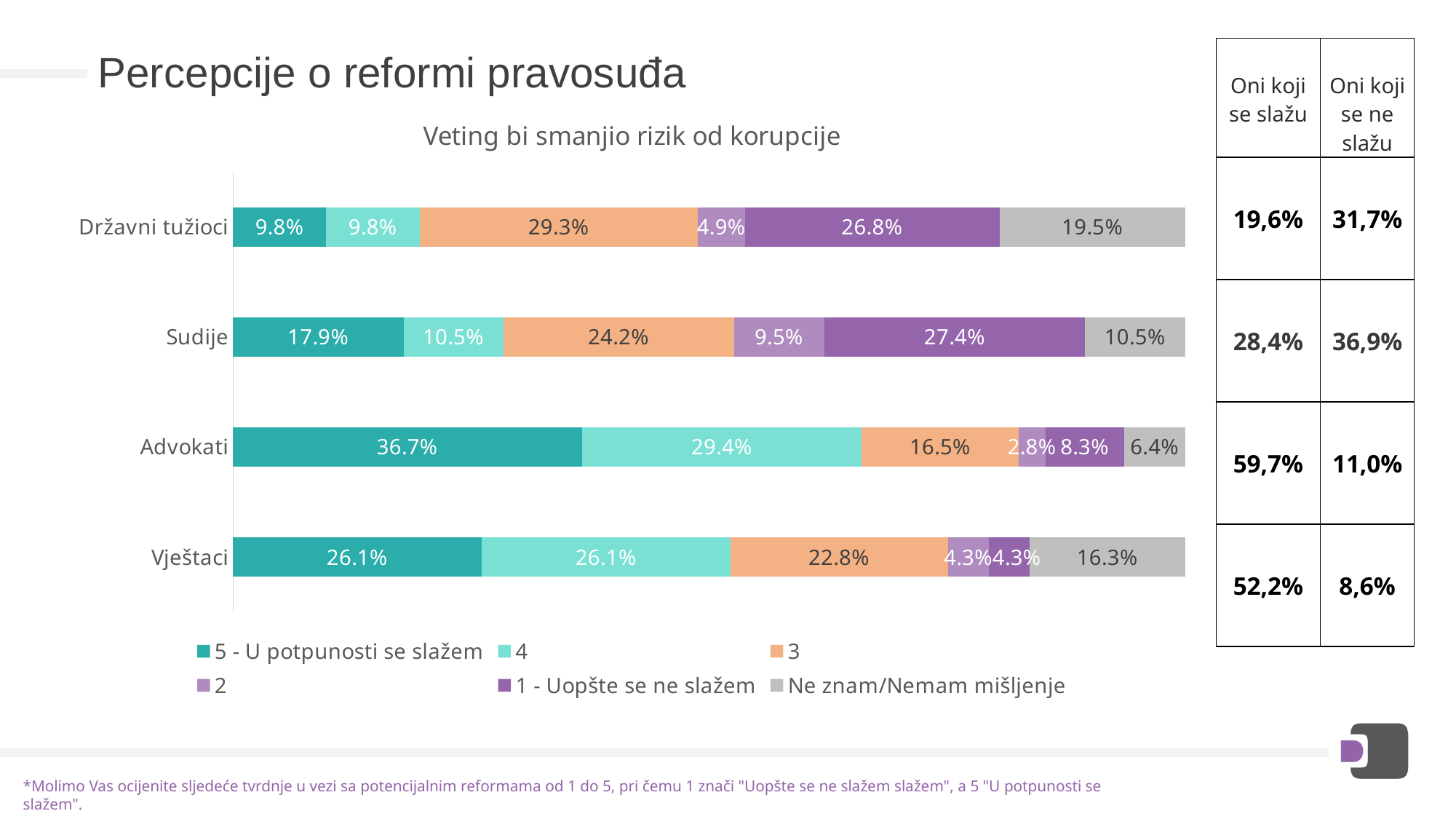
What is the value for Državni tužioci in the 'Ne znam/Nemam mišljenje' series? 19.5% What kind of chart is shown on the slide? Stacked bar chart Which is larger: the '1 - Uopšte se ne slažem' value for Državni tužioci or for Vještaci? Državni tužioci What is the value for Vještaci in the '3' series? 22.8% What is the title of the chart? Veting bi smanjio rizik od korupcije Which category has the lowest value in the 'Ne znam/Nemam mišljenje' series? Advokati What is the value for Sudije in the '1 - Uopšte se ne slažem' series? 27.4% What is the value for Advokati in the '5 - U potpunosti se slažem' series? 36.7% How many series does the legend list? 6 Which category has the highest value in the '5 - U potpunosti se slažem' series? Advokati How many categories are shown on the chart? 4 What is the difference between the '5 - U potpunosti se slažem' values for Advokati and Sudije? 18.8%